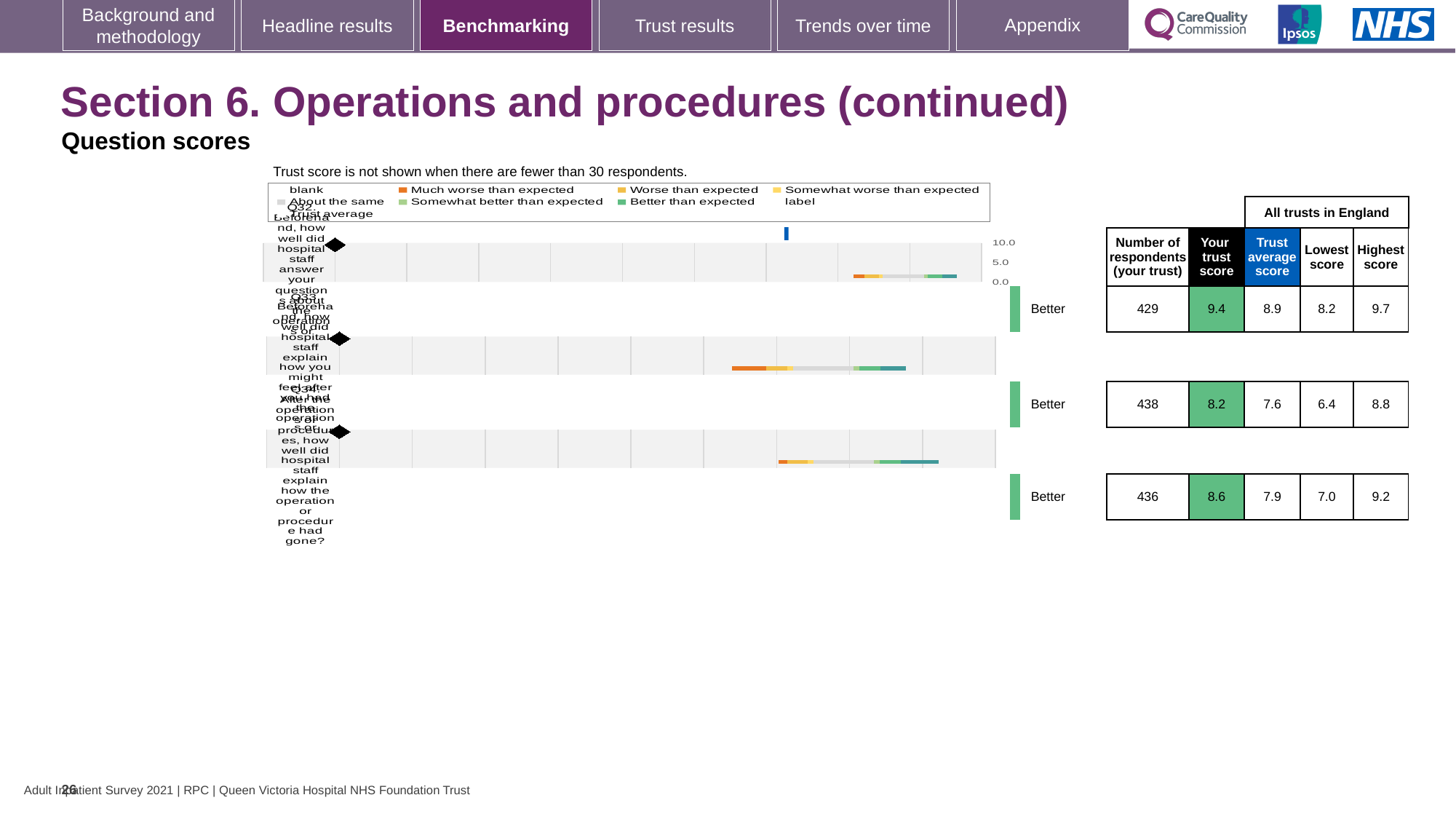
What word is shown next to the green bar for each question row? Better How many question rows are plotted in the benchmarking chart? 3 What is the 'Trust average score' for the second question row? 7.6 How many respondents are shown for the first question row (Q32) in the benchmarking table? 429 How many respondents are shown for the third question row? 436 Is the 'Trust average score' for the third question row greater or less than 5.0? greater For the first question row (Q32), what is the difference between 'Your trust score' and the 'Trust average score'? 0.5 What is the 'Lowest score' for the second question row? 6.4 What is the 'Highest score' for the third question row? 9.2 For the second question row, which is larger: 'Your trust score' or the 'Trust average score'? Your trust score Which question row has the highest 'Your trust score'? The first row (Q32), 9.4 What is 'Your trust score' for the first question row (Q32)? 9.4